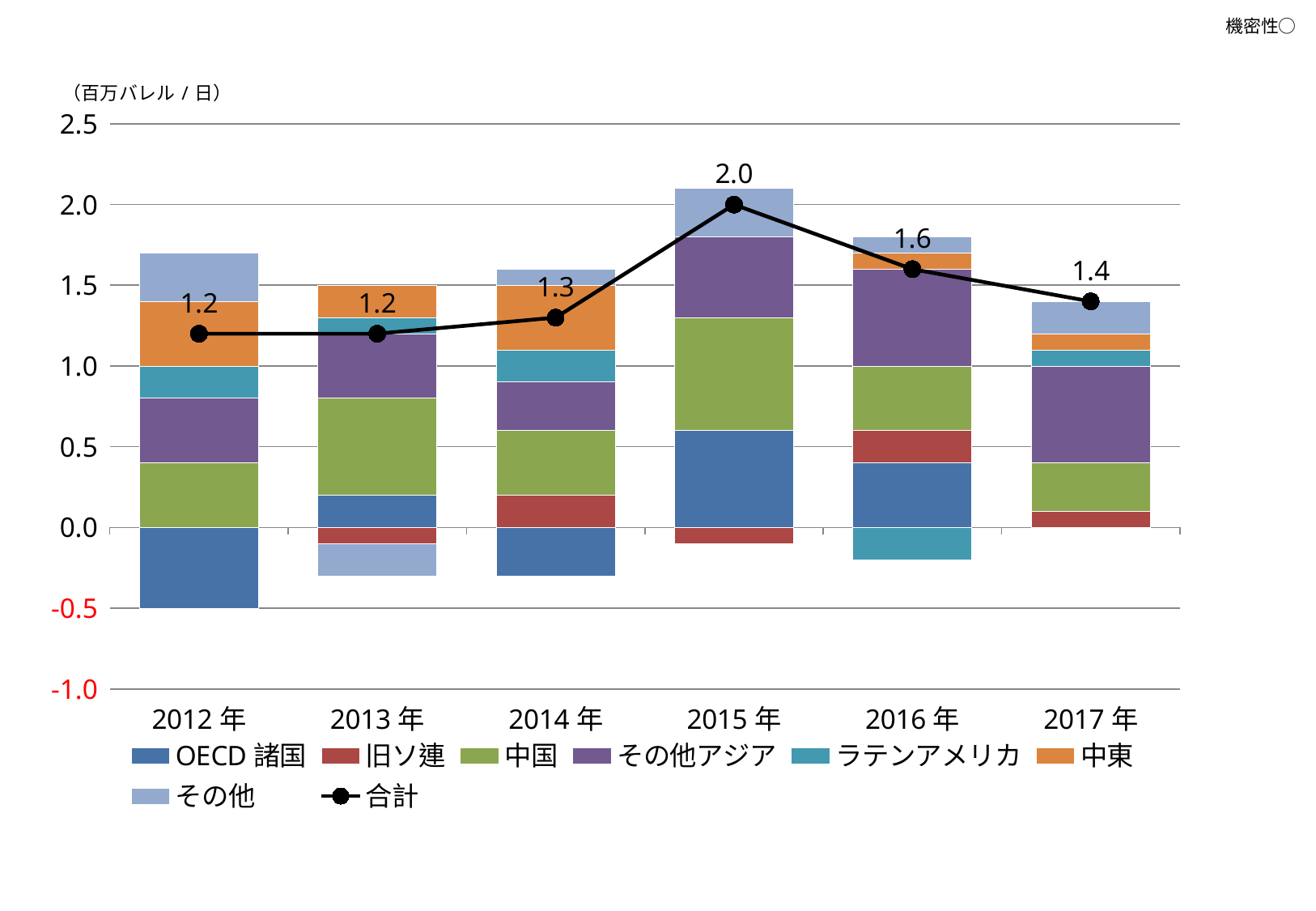
What is the value of 合計 for 2014年? 1.3 What is the difference between the 合計 values for 2015年 and 2012年? 0.8 What unit is shown above the y axis? 百万バレル / 日 What kind of chart is this? Stacked bar chart with a line What is the value of 合計 for 2015年? 2.0 Which is larger, the 合計 value for 2016年 or for 2017年? 2016年 Does the 合計 line rise or fall from 2015年 to 2017年? fall Is the value for OECD諸国 in 2012年 greater or less than 0.0? less What is the value of 合計 for 2017年? 1.4 In which year is the 合計 value highest? 2015年 How many series does the legend list? 8 How many years are shown on the x axis? 6